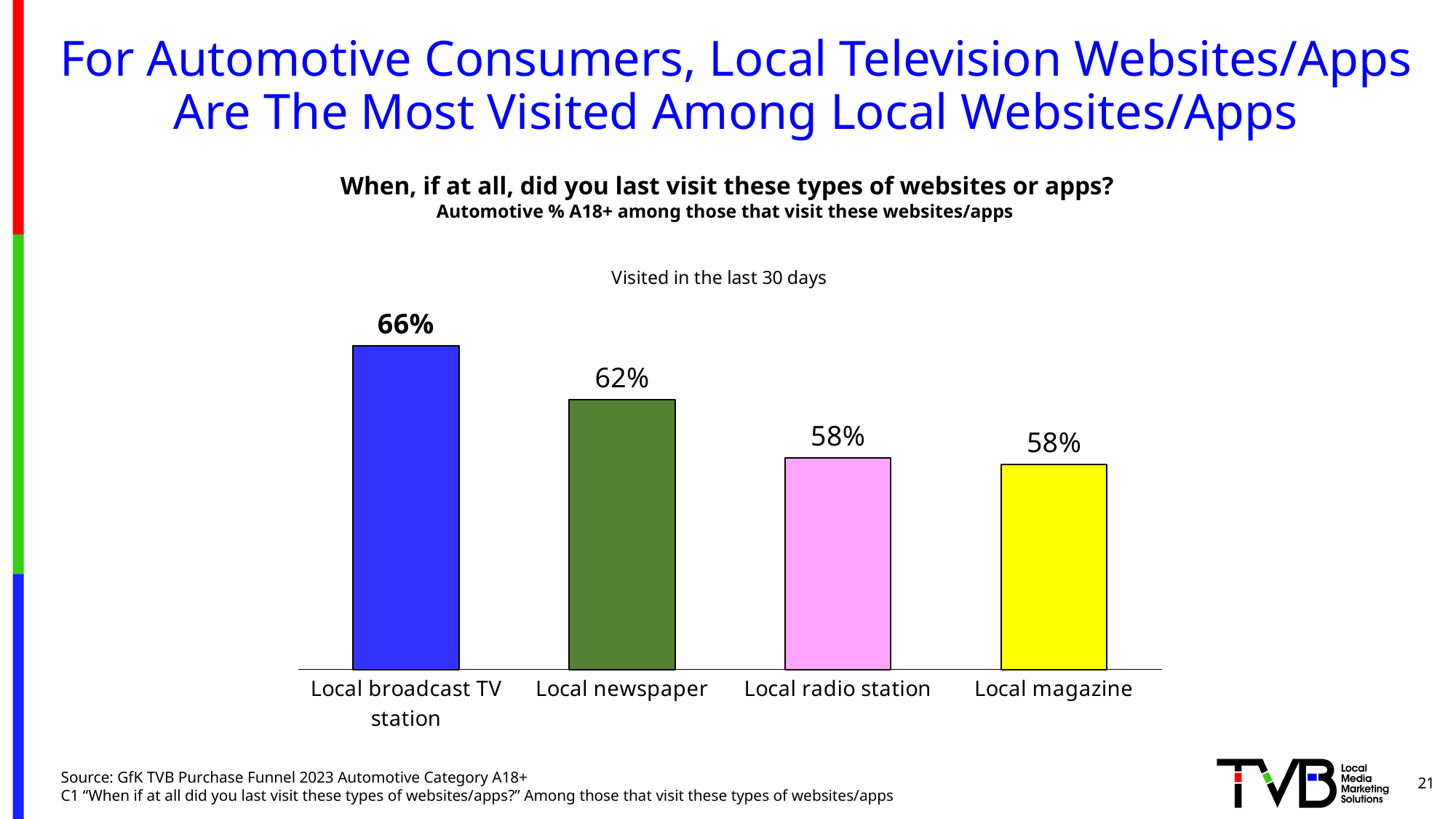
How many categories are shown in the chart? 4 What is the title shown directly above the bars of the chart? Visited in the last 30 days What is the difference between the values for Local newspaper and Local radio station? 4% What is the value for Local magazine? 58% What is the value for Local broadcast TV station? 66% What is the value for Local newspaper? 62% What is the difference between the values for Local broadcast TV station and Local newspaper? 4% Do the values rise or fall from left to right across the categories? Fall What kind of chart is shown on the slide? Bar chart What is the value for Local radio station? 58% Which category has the highest value? Local broadcast TV station Which is larger, the value for Local newspaper or the value for Local magazine? Local newspaper